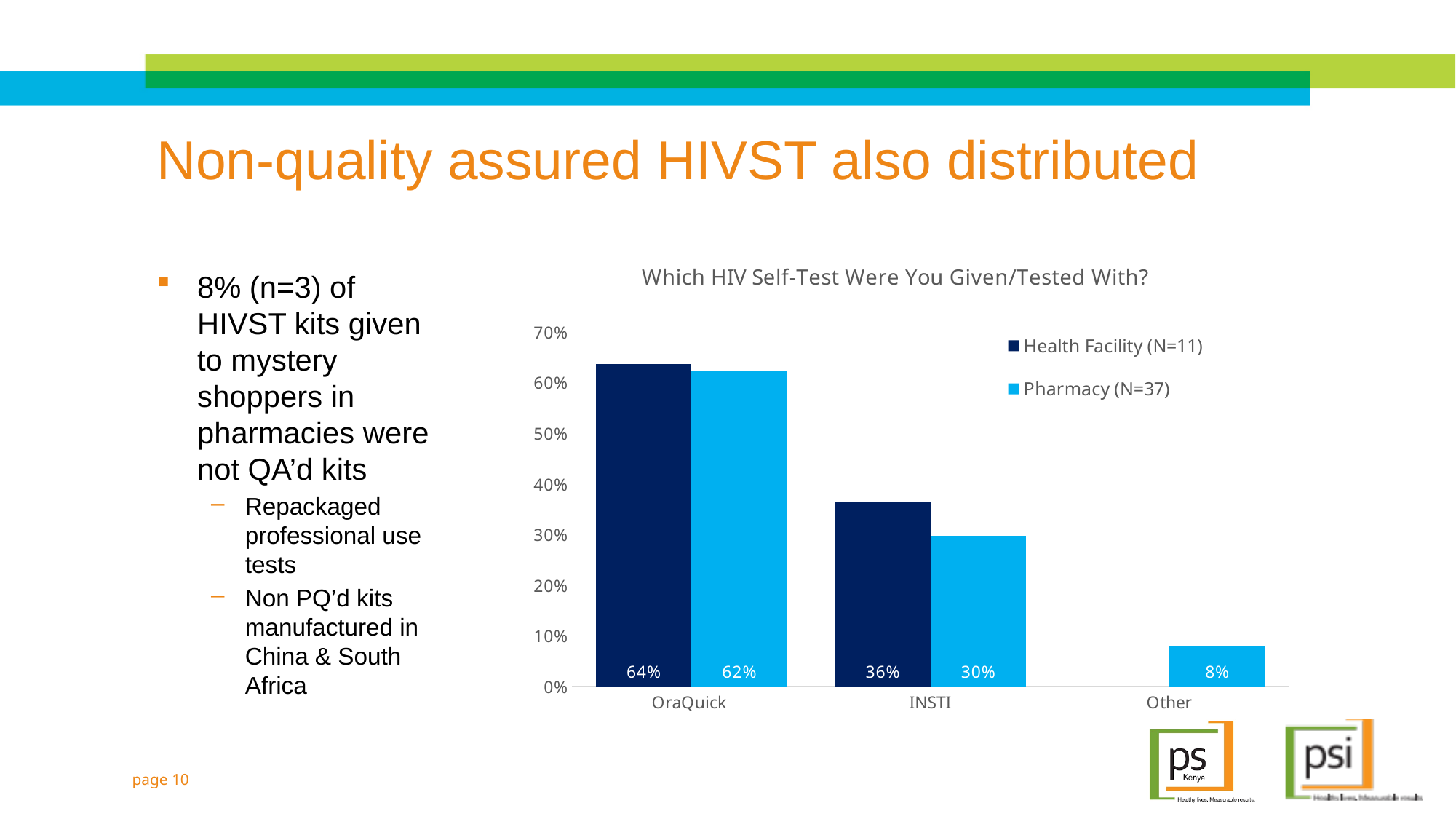
How many categories are shown on the x axis? 3 Is the Pharmacy (N=37) value for INSTI greater or less than 40%? less What is the difference between the Health Facility (N=11) and Pharmacy (N=37) values for INSTI? 6% Which category has the lowest Pharmacy (N=37) value? Other What kind of chart is shown on the slide? bar chart What is the Pharmacy (N=37) value for OraQuick? 62% Which is larger for OraQuick: the Health Facility (N=11) value or the Pharmacy (N=37) value? Health Facility (N=11) What is the Pharmacy (N=37) value for Other? 8% What is the Health Facility (N=11) value for INSTI? 36% How many series does the legend list? 2 What is the title of the chart? Which HIV Self-Test Were You Given/Tested With? Which category has the highest Health Facility (N=11) value? OraQuick